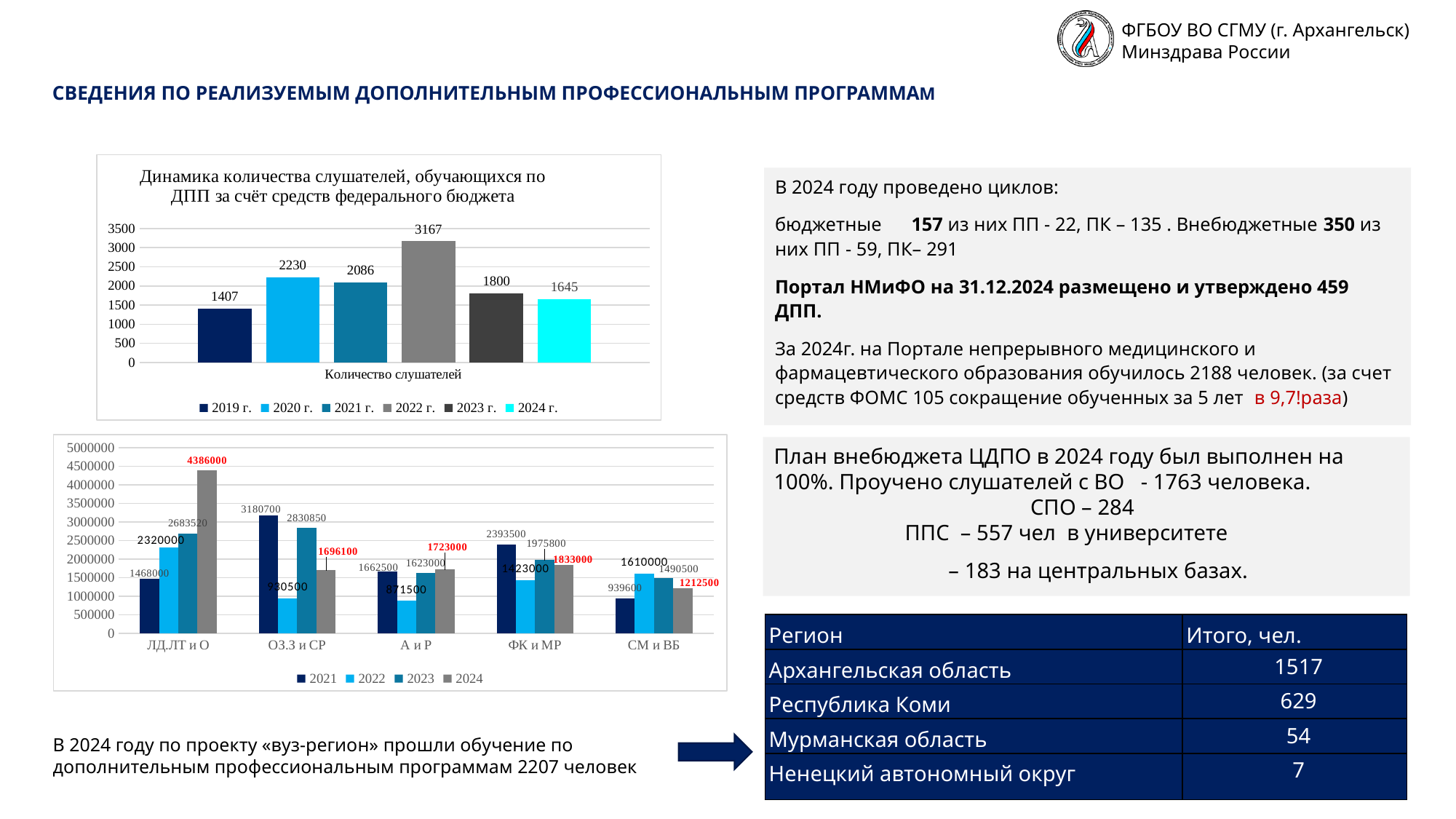
In the bottom chart, what is the difference between the 2021 and 2022 values for the category СМ и ВБ? 670400 In the top chart 'Динамика количества слушателей...', which year has the highest value? 2022 г. In the top chart 'Динамика количества слушателей, обучающихся по ДПП за счёт средств федерального бюджета', what is the value for 2022 г.? 3167 In the top chart 'Динамика количества слушателей...', how many series does the legend list? 6 In the top chart 'Динамика количества слушателей...', what is the difference between the values for 2020 г. and 2024 г.? 585 What kind of chart is the top chart 'Динамика количества слушателей...'? bar chart In the bottom chart, what is the value for 2024 in the category ЛД,ЛТ и О? 4386000 In the bottom chart, which is larger for the category ФК и МР: the 2021 value or the 2023 value? 2021 In the top chart 'Динамика количества слушателей...', what is the value for 2019 г.? 1407 In the top chart 'Динамика количества слушателей...', which year has the lowest value? 2019 г. In the bottom chart, how many categories are shown on the x axis? 5 In the bottom chart, what is the value for 2022 in the category ОЗ.З и СР? 930500